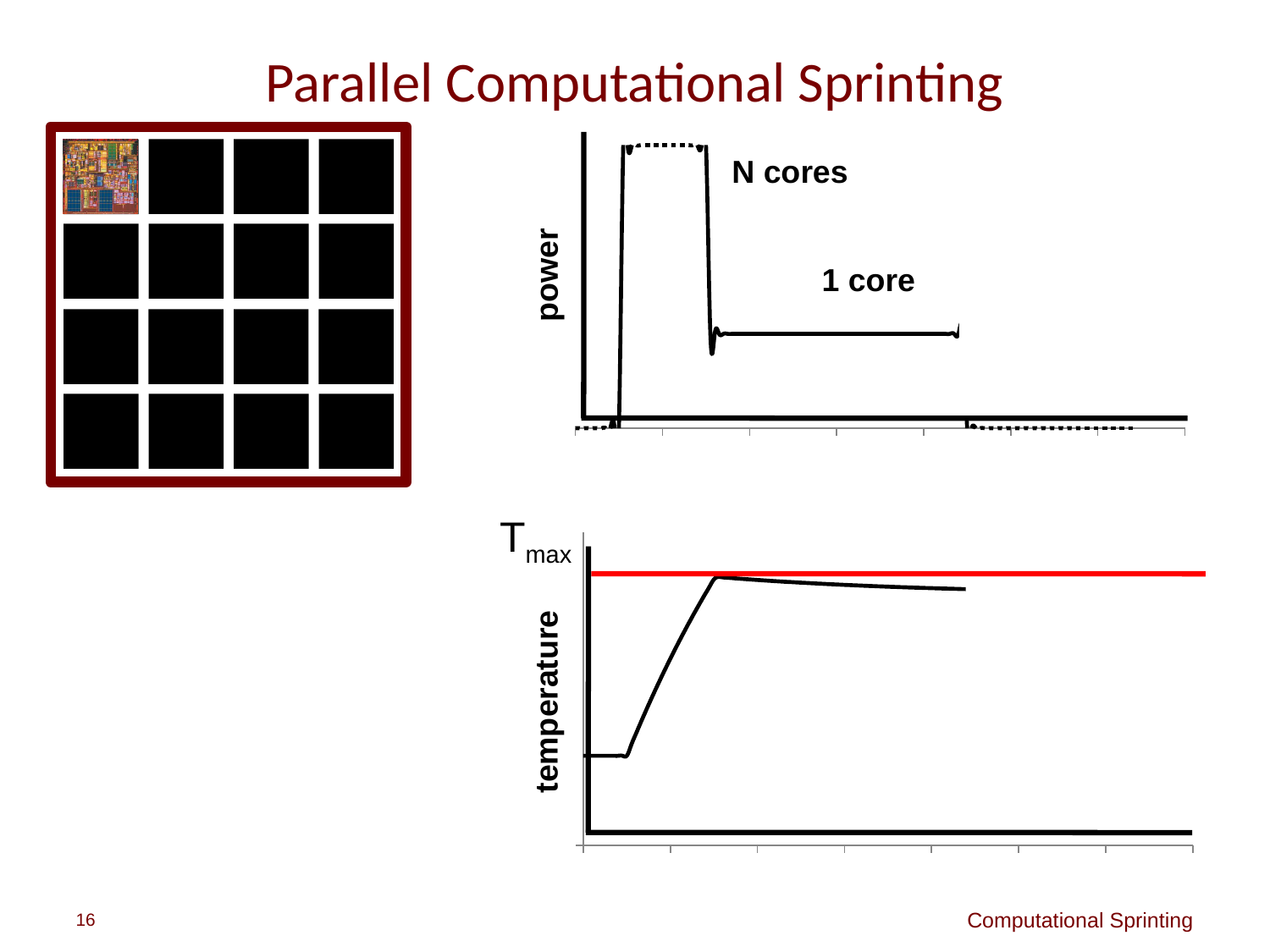
In the top chart, which phase has the higher power level, N cores or 1 core? N cores In the bottom chart, does the temperature rise or fall during the first part of the curve, before it reaches its peak? rise In the bottom chart, what is the label on the vertical axis? temperature In the top chart, what is the label on the vertical axis? power What kind of chart is the top chart on the slide? line chart In the top chart, does the power level rise or fall when the system goes from the N cores phase to the 1 core phase? fall How many charts are shown on the slide? 2 In the bottom chart, does the black temperature curve stay below or go above the red Tmax line? below In the bottom chart, after the temperature reaches its peak, does it rise or fall along the rest of the curve? fall In the top chart, which phase lasts longer along the x axis, N cores or 1 core? 1 core What kind of chart is the bottom chart on the slide? line chart